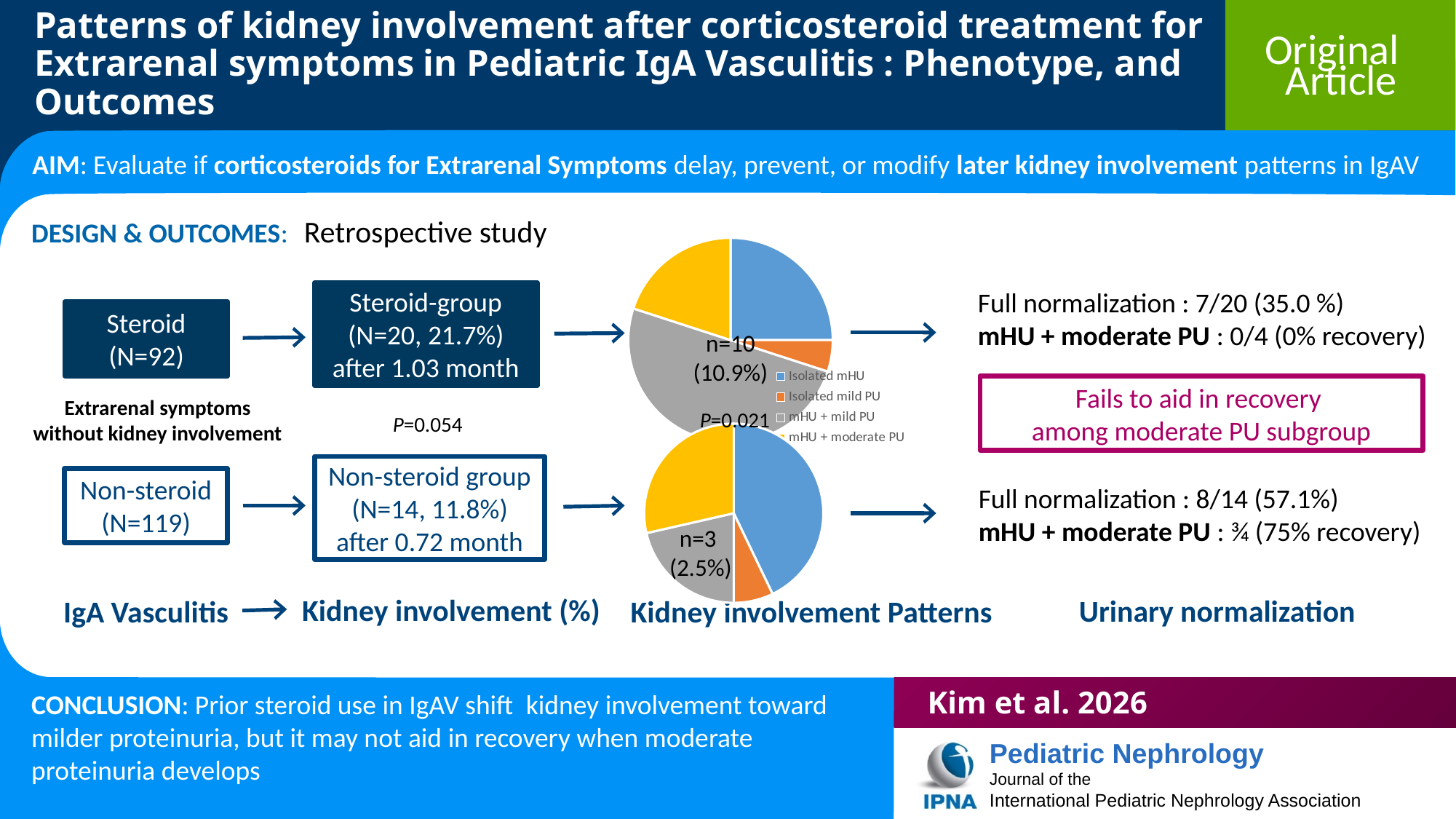
In the bottom pie chart (non-steroid group), which slice is larger: Isolated mHU or mHU + mild PU? Isolated mHU In the top pie chart (steroid group), which category has the smallest slice? Isolated mild PU What kind of chart is used to show the kidney involvement patterns for the steroid group (top chart)? Pie chart How many categories does the legend list for the kidney involvement pattern pie charts? 4 In the bottom pie chart (non-steroid group), which category has the largest slice? Isolated mHU In the bottom pie chart (non-steroid group), which slice is larger: mHU + moderate PU or Isolated mild PU? mHU + moderate PU How many slices does the top pie chart (steroid group) have? 4 In the top pie chart (steroid group), which category has the largest slice? mHU + mild PU Which category is shown in yellow in the pie charts? mHU + moderate PU In the bottom pie chart (non-steroid group), which category has the smallest slice? Isolated mild PU In the top pie chart (steroid group), which slice is larger: Isolated mHU or Isolated mild PU? Isolated mHU What colour represents the Isolated mHU category in the pie charts? Blue